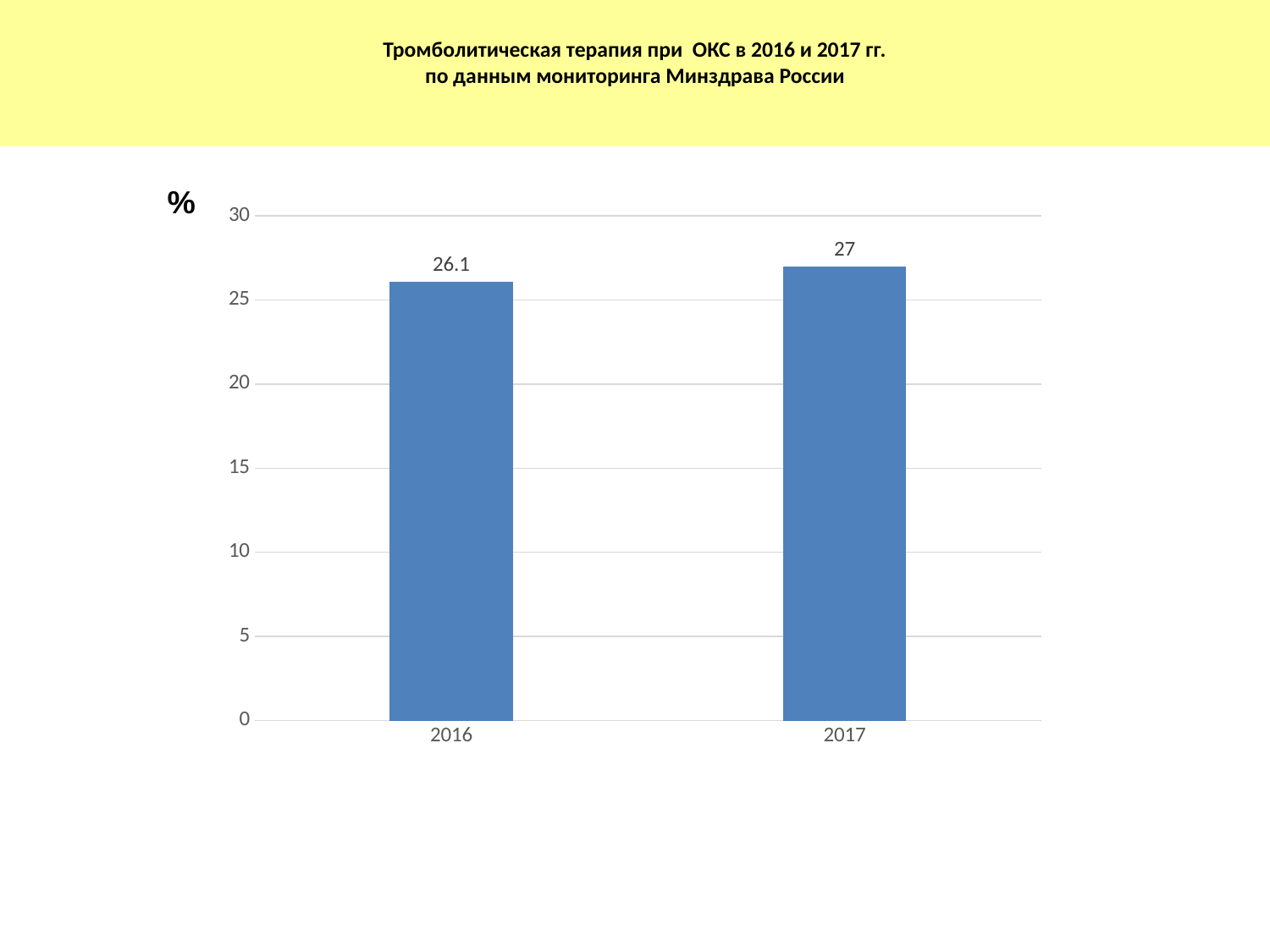
What kind of chart is shown on the slide? bar chart Is the value for 2016 greater or less than 25? greater How many categories are shown on the x axis? 2 What is the value for 2017? 27 What is the value for 2016? 26.1 Which year has the highest value? 2017 What unit label is shown next to the vertical axis? % Is the value for 2017 greater or less than 30? less Do the values rise or fall from 2016 to 2017? rise Which is larger, the value for 2016 or the value for 2017? 2017 What is the difference between the values for 2017 and 2016? 0.9 Which year has the lowest value? 2016